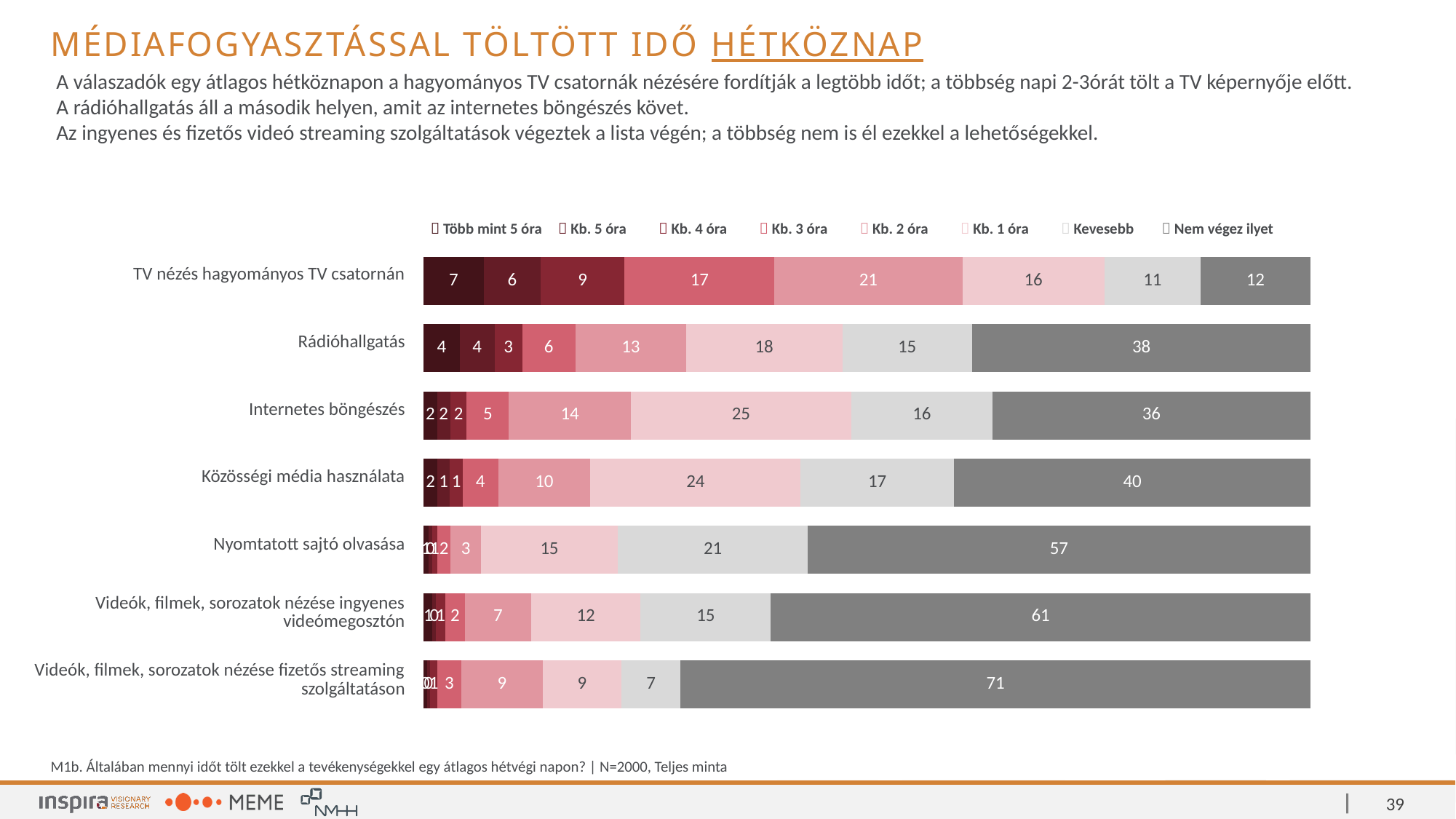
What is the difference between the 'Nem végez ilyet' values for 'Nyomtatott sajtó olvasása' and 'Közösségi média használata'? 17 What kind of chart is shown on the slide? stacked bar chart What is the value of 'Nem végez ilyet' for 'TV nézés hagyományos TV csatornán'? 12 What is the value of 'Nem végez ilyet' for 'Videók, filmek, sorozatok nézése fizetős streaming szolgáltatáson'? 71 Which is larger: the 'Kb. 3 óra' value for 'TV nézés hagyományos TV csatornán' or for 'Rádióhallgatás'? TV nézés hagyományos TV csatornán What is the value of 'Kb. 2 óra' for 'Rádióhallgatás'? 13 Which activity has the highest 'Nem végez ilyet' value? Videók, filmek, sorozatok nézése fizetős streaming szolgáltatáson What is the first series listed in the legend? Több mint 5 óra How many series does the legend list? 8 What is the value of 'Kb. 1 óra' for 'Internetes böngészés'? 25 Which activity has the lowest 'Nem végez ilyet' value? TV nézés hagyományos TV csatornán How many categories (activities) are plotted in the chart? 7